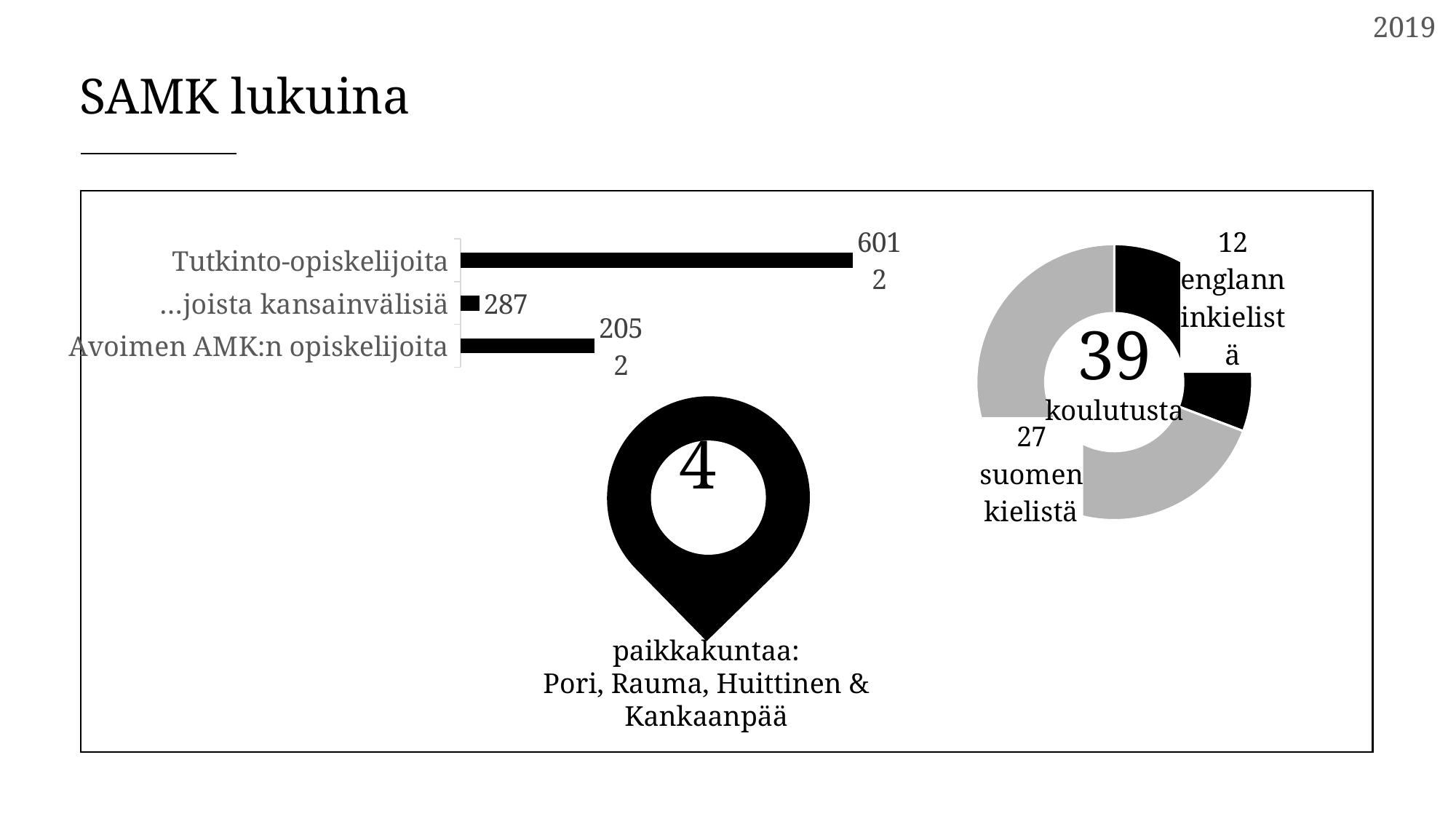
What number is shown in the centre of the doughnut chart on the right? 39 In the doughnut chart on the right, how many suomenkielistä (Finnish-language) programmes are shown? 27 In the bar chart on the left, what is the difference between Tutkinto-opiskelijoita and Avoimen AMK:n opiskelijoita? 3960 In the bar chart on the left, which is larger: Avoimen AMK:n opiskelijoita or ...joista kansainvälisiä? Avoimen AMK:n opiskelijoita In the doughnut chart on the right, how many englanninkielistä (English-language) programmes are shown? 12 How many categories does the bar chart on the left show? 3 In the bar chart on the left, what is the value for ...joista kansainvälisiä? 287 In the bar chart on the left, what is the value for Avoimen AMK:n opiskelijoita? 2052 In the bar chart on the left, what is the value for Tutkinto-opiskelijoita? 6012 In the bar chart on the left, which category has the lowest value? ...joista kansainvälisiä What kind of chart is the chart on the left of the slide? bar chart In the bar chart on the left, which category has the highest value? Tutkinto-opiskelijoita